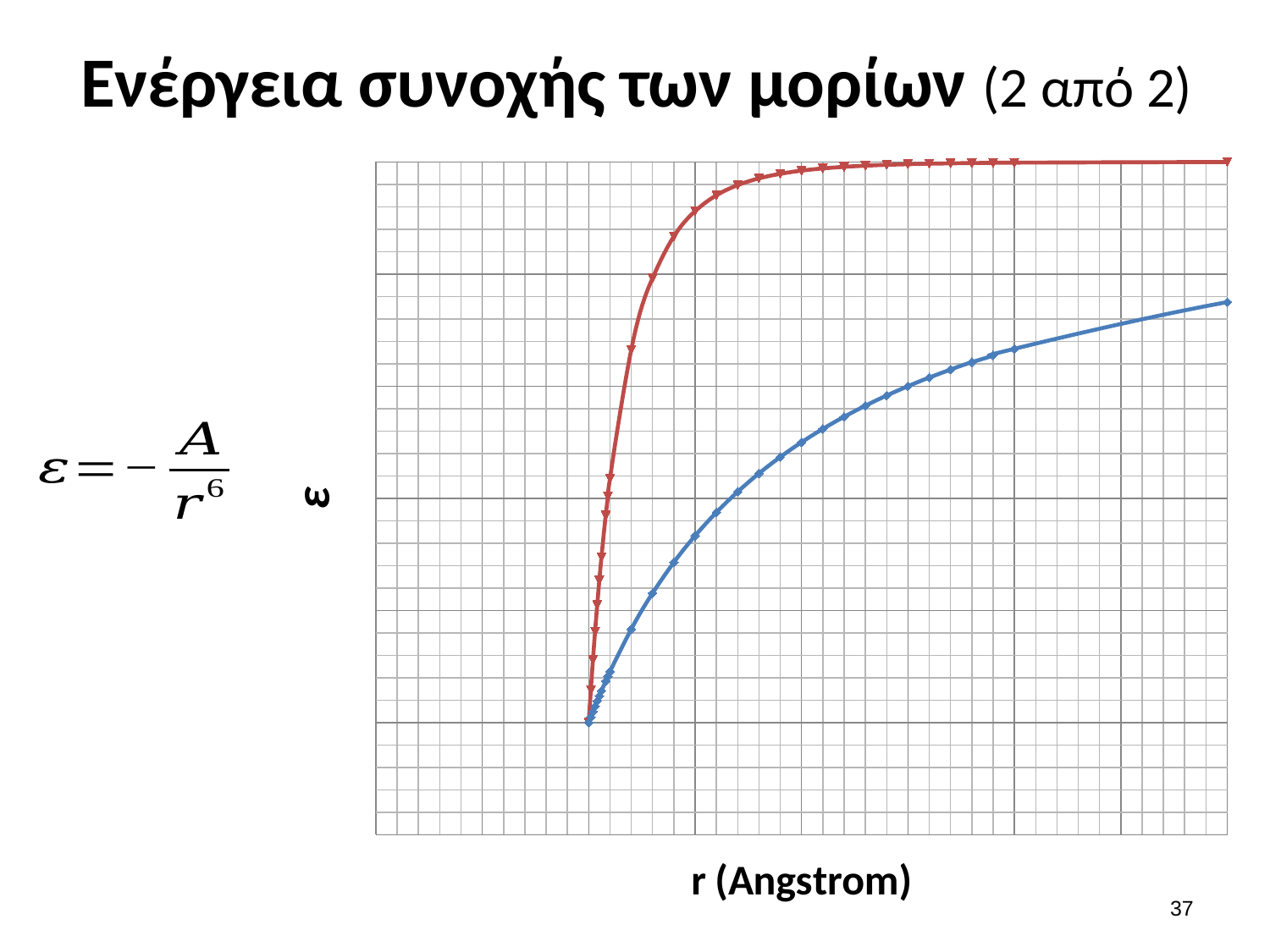
Which line rises more steeply at small values of r, the red line or the blue line? the red line How many lines (series) are plotted on the chart? 2 At the right end of the chart, which line has the higher value, the red line or the blue line? the red line What is the label of the y axis of the chart? ε Do the values of the red line rise or fall as r increases along the x axis? rise What is the label of the x axis of the chart? r (Angstrom) What kind of chart is shown on the slide? line chart Do the values of the blue line rise or fall as r increases along the x axis? rise Does the chart display a legend? No Which line flattens out (levels off) first as r increases, the red line or the blue line? the red line